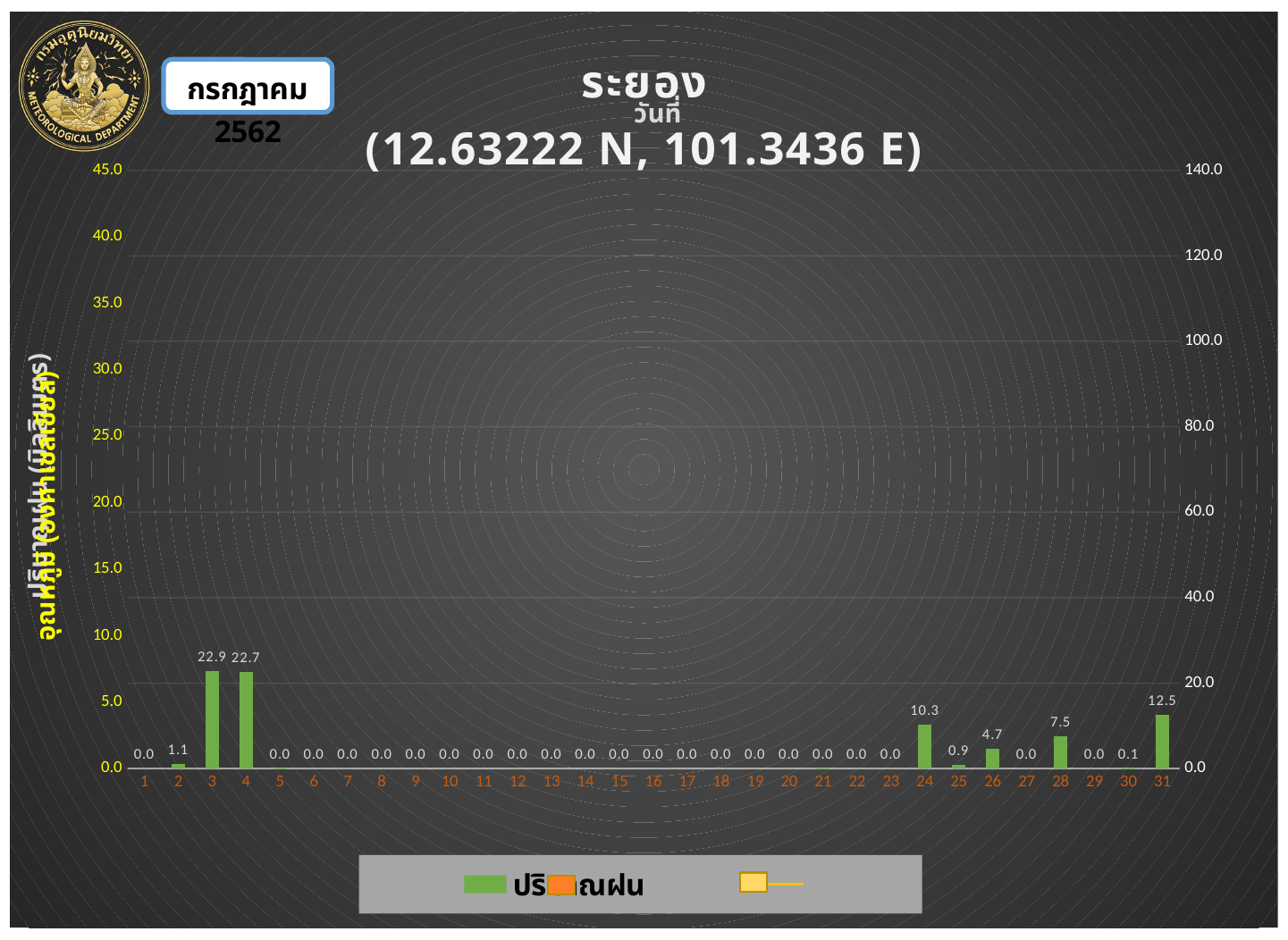
Which day has the larger rainfall value, day 2 or day 25? 2 What is the rainfall value shown for day 26? 4.7 What is the rainfall value shown for day 3? 22.9 What kind of chart is shown on the slide? bar chart What is the rainfall value shown for day 24? 10.3 What coordinates are shown in the chart title? (12.63222 N, 101.3436 E) What is the rainfall value shown for day 31? 12.5 What is the difference between the rainfall values for day 3 and day 4? 0.2 What is the difference between the rainfall values for day 28 and day 26? 2.8 Which day has the larger rainfall value, day 24 or day 31? 31 How many days are shown on the x axis of the chart? 31 Which day has the highest rainfall value? 3